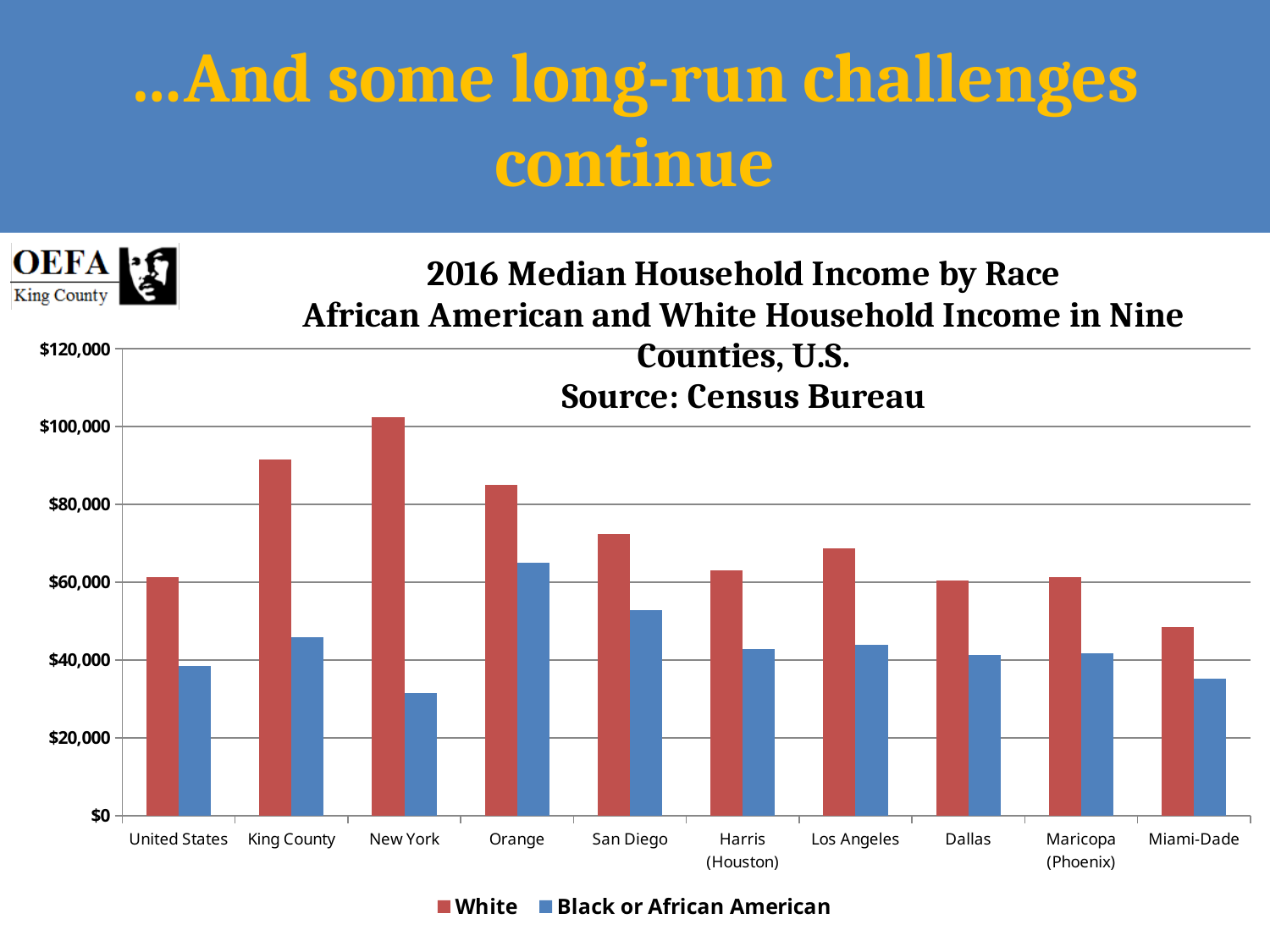
Which category has the highest Black or African American median household income? Orange Which is larger: the White median household income for King County or for Orange? King County Which category has the lowest Black or African American median household income? New York Is the Black or African American median household income for New York greater or less than $40,000? less What source is cited in the chart title? Census Bureau Which category has the highest White median household income? New York Is the Black or African American median household income for Orange greater or less than $60,000? greater What kind of chart is shown on the slide? bar chart Which category has the lowest White median household income? Miami-Dade How many counties/categories are shown along the x axis? 10 How many series does the legend list? 2 Is the White median household income for King County greater or less than $80,000? greater